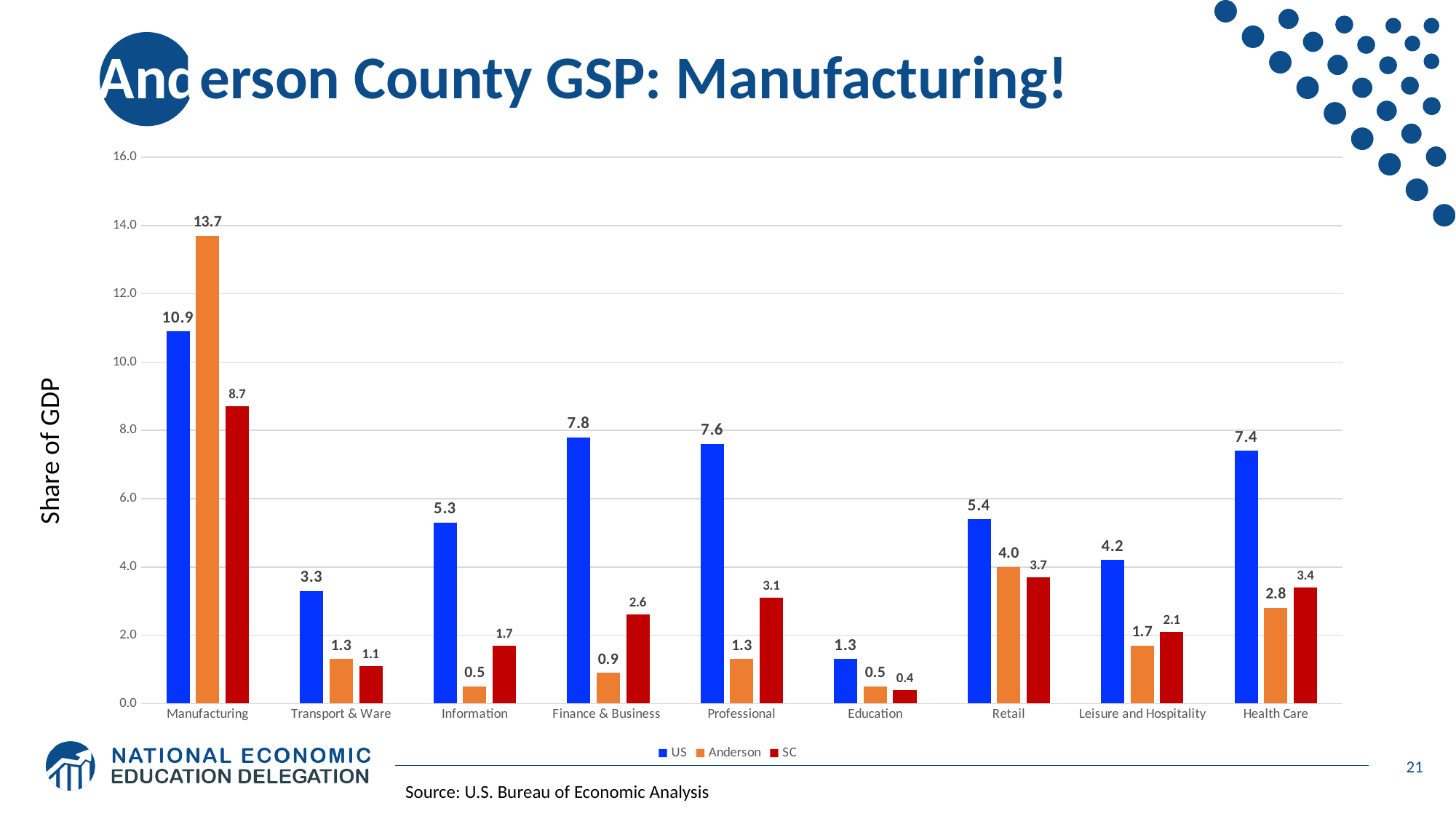
How many categories are shown on the x axis? 9 How many series does the legend list? 3 What is the y-axis label of the chart? Share of GDP Which is larger for Retail: the Anderson value or the SC value? Anderson What is the difference between the Anderson and US values for Manufacturing? 2.8 What kind of chart is shown on the slide? Bar chart Which colour represents the SC series in the legend? Red Which category has the highest Anderson value? Manufacturing What is the Anderson value for Manufacturing? 13.7 What is the US value for Health Care? 7.4 What is the SC value for Finance & Business? 2.6 Which category has the lowest SC value? Education